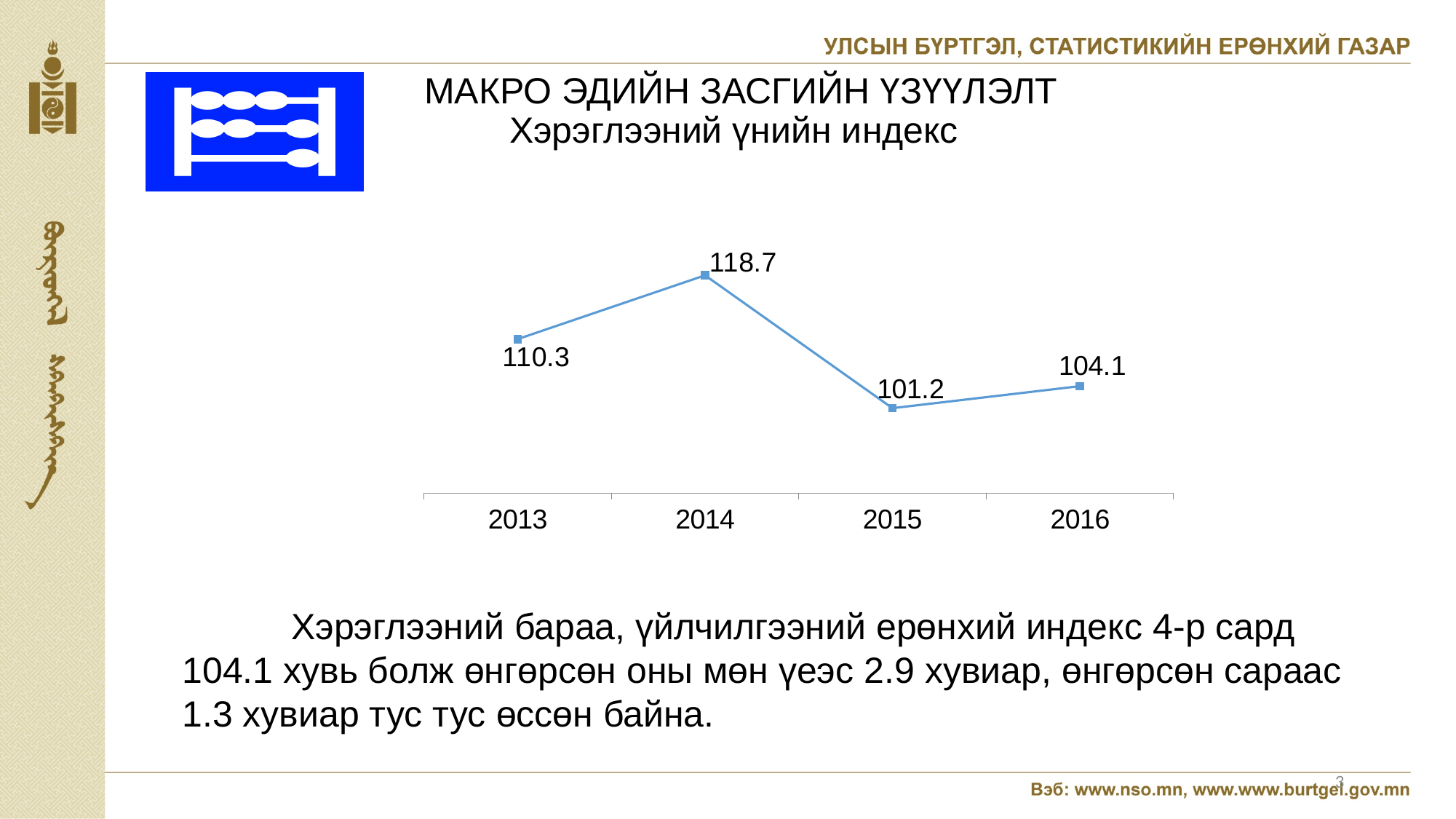
What is the value for 2015? 101.2 Which year has the highest value? 2014 What is the value for 2013? 110.3 How many years are plotted on the chart? 4 What is the value for 2016? 104.1 Which is larger, the value for 2013 or the value for 2016? 2013 What is the difference between the values for 2016 and 2015? 2.9 What kind of chart is shown on the slide? line chart What is the value for 2014? 118.7 Which year has the lowest value? 2015 Does the value rise or fall from 2014 to 2015? fall What is the difference between the values for 2014 and 2015? 17.5